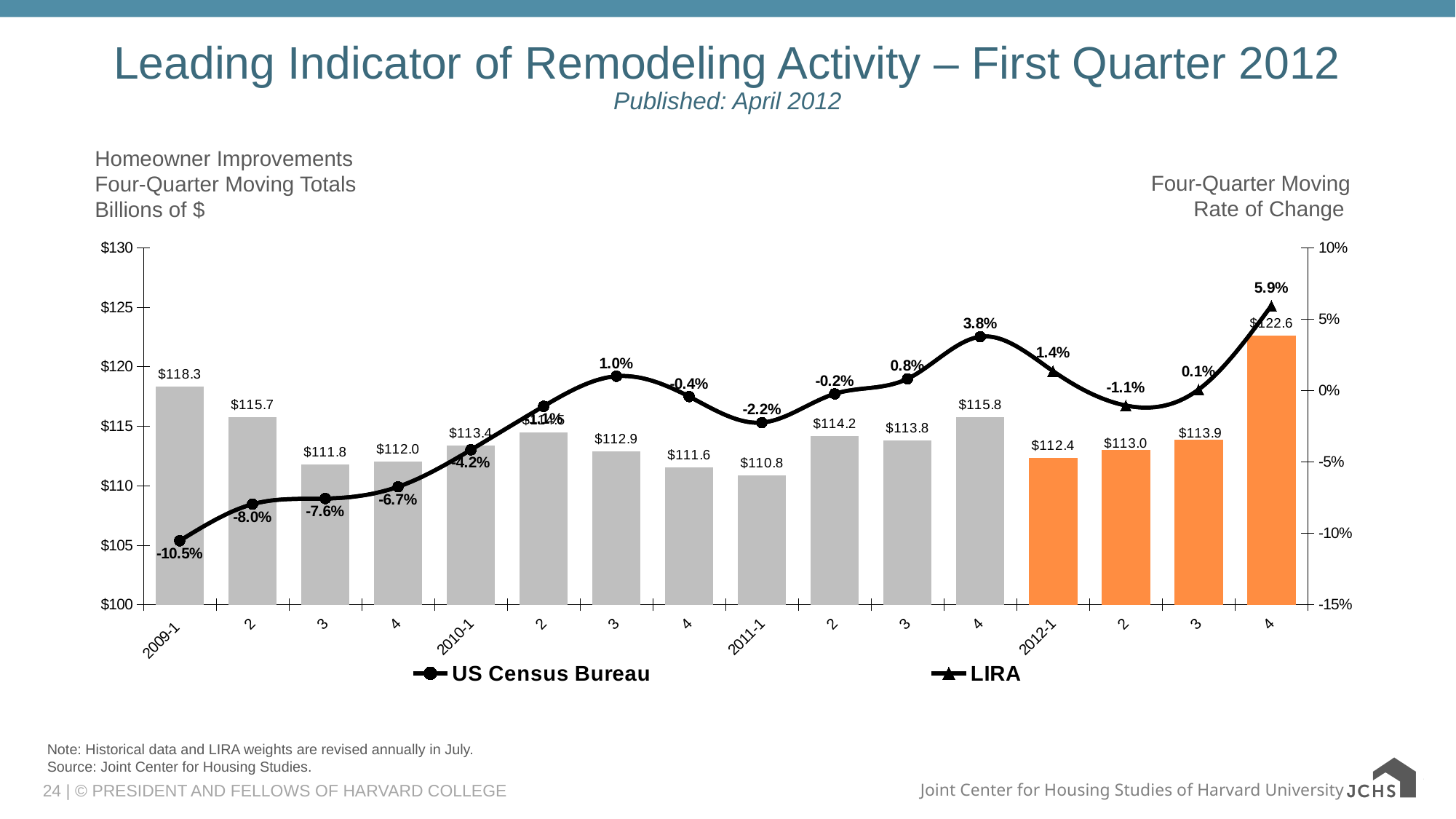
How many series does the legend list? 2 Does the rate of change line rise or fall from 2009-1 to 2010-3? Rises What is the rate of change shown for 2012-1? 1.4% What kind of chart is this? Combined bar and line chart Which is larger, the four-quarter moving total for 2009-2 or for 2011-2? 2009-2 ($115.7) How many quarterly bars are plotted on the chart? 16 What is the four-quarter moving total of homeowner improvements for 2009-1? $118.3 Which quarter has the lowest four-quarter moving total bar? 2011-1 ($110.8) What is the four-quarter moving rate of change shown for 2011-4? 3.8% What is the difference between the four-quarter moving totals for 2011-4 and 2011-3? $2.0 Which quarter has the highest four-quarter moving total bar? 2012-4 ($122.6) Which quarters are shown with orange bars? 2012-1 through 2012-4